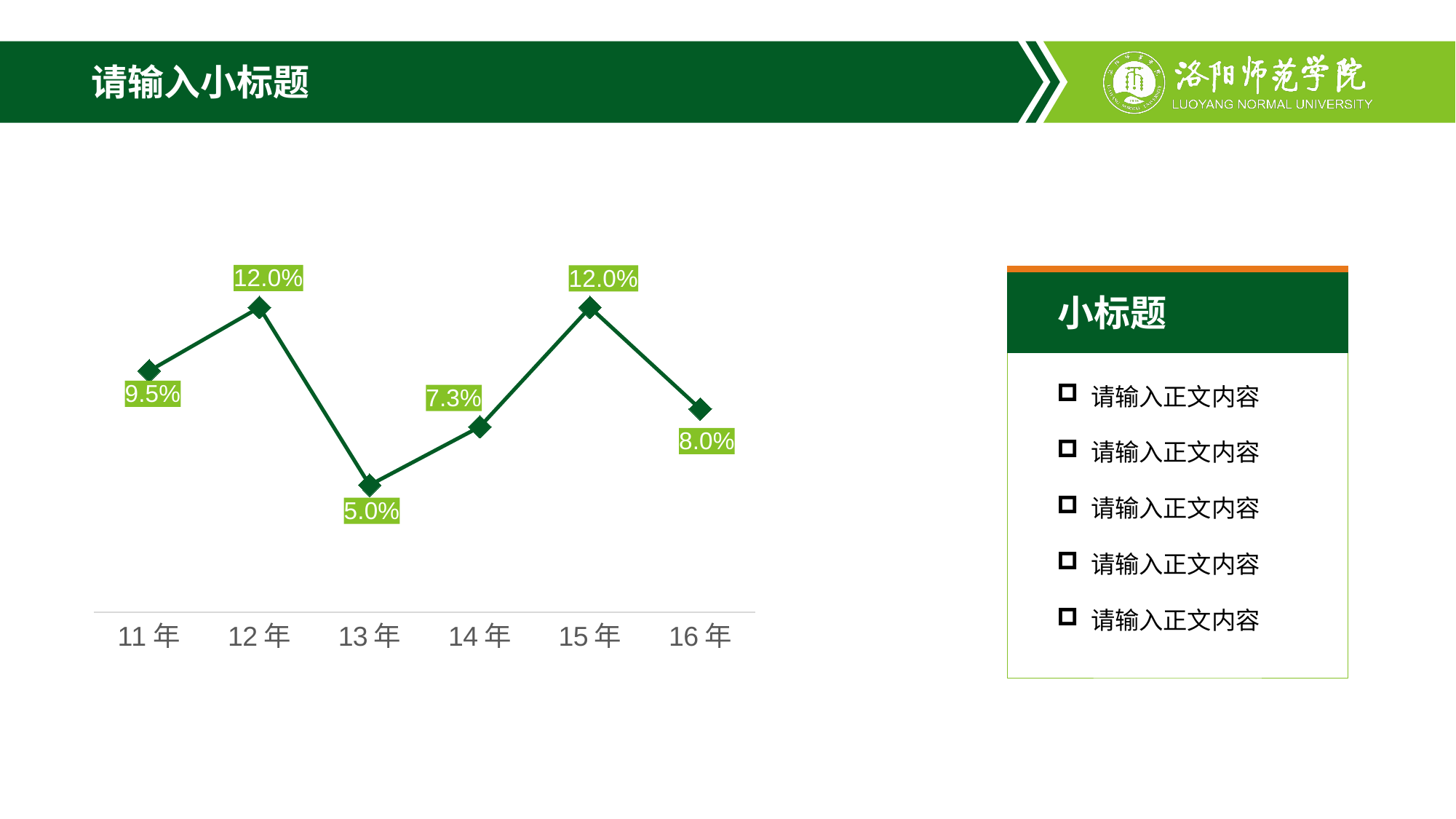
What is the highest value shown on the chart? 12.0% Which year has the lowest value? 13 年 What is the value for 11 年? 9.5% What is the value for 14 年? 7.3% Which is larger, the value for 11 年 or the value for 16 年? 11 年 What is the difference between the values for 16 年 and 14 年? 0.7% What is the value for 16 年? 8.0% What is the difference between the values for 12 年 and 13 年? 7.0% How many data points are plotted on the chart? 6 What is the value for 13 年? 5.0% Does the value rise or fall from 15 年 to 16 年? fall What type of chart is shown on the slide? line chart